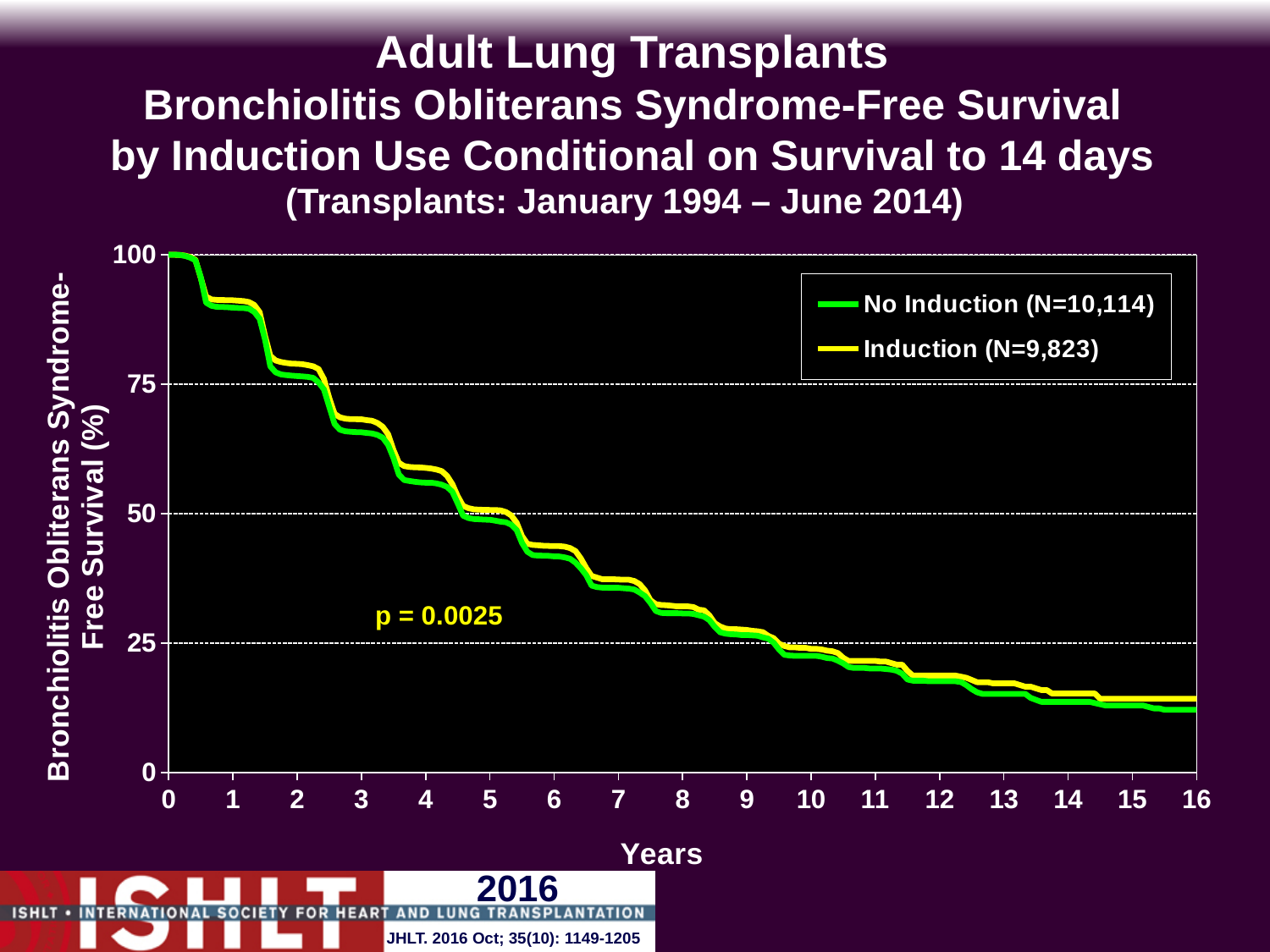
Is the value for the No Induction series at year 8 greater or less than 25? greater Is the value for the No Induction series at year 3 greater or less than 75? less Is the value for the Induction series at year 1 greater or less than 75? greater Do the survival curves rise or fall as years increase along the x axis? fall What is the label of the x axis? Years What are the two series named in the legend? No Induction (N=10,114) and Induction (N=9,823) What kind of chart is shown on the slide? line chart How many series does the legend list? 2 What is the p-value printed on the chart? p = 0.0025